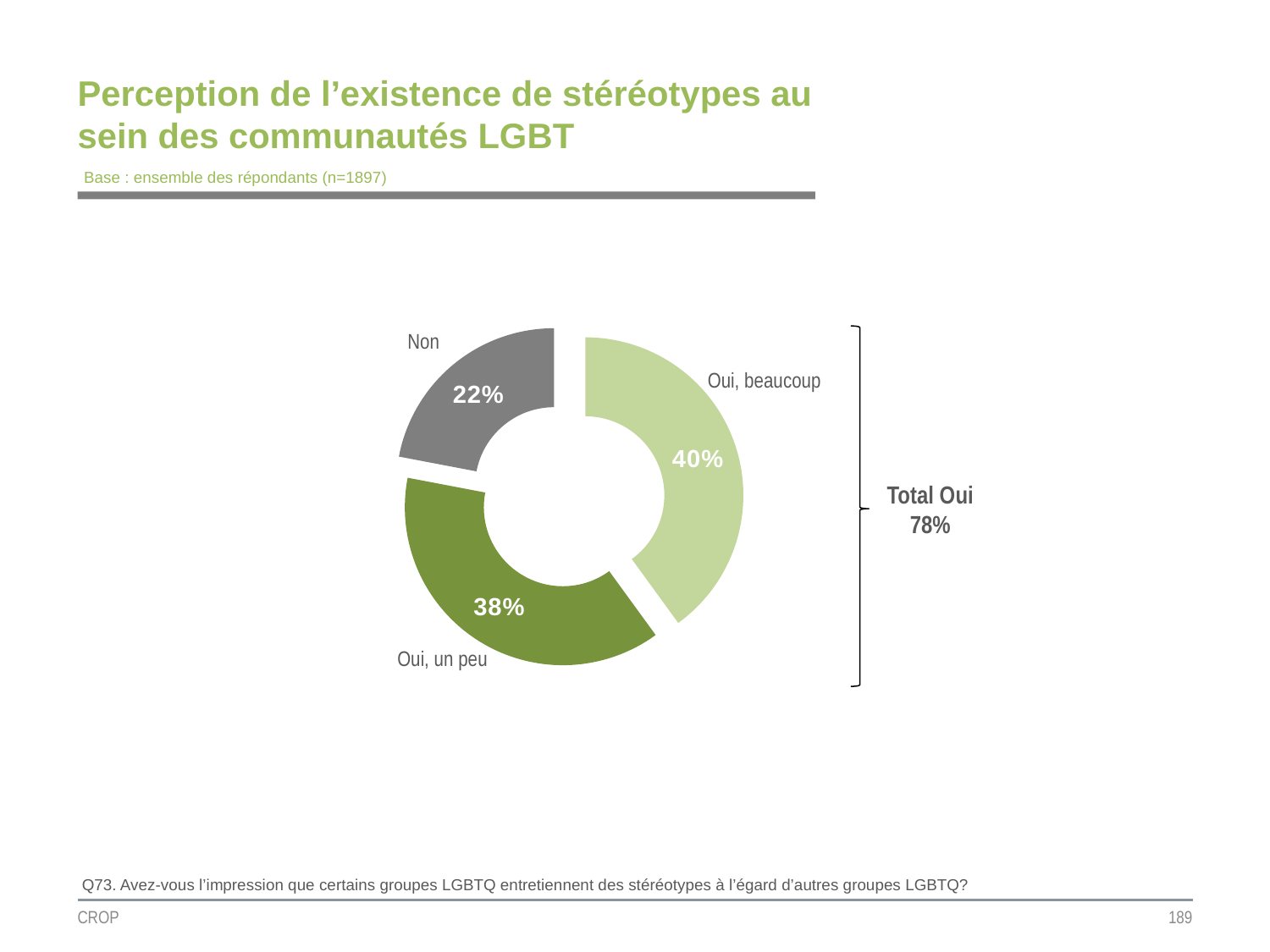
Which response category has the smallest share? Non What kind of chart is shown on the slide? Pie chart (doughnut) What is the difference in percentage points between "Oui, un peu" and "Non"? 16 What is the sample size (n) stated in the base line under the title? 1897 Which response category has the largest share? Oui, beaucoup What percentage of respondents answered "Oui, un peu"? 38% What percentage of respondents answered "Non"? 22% What is the combined share of the two "Oui" responses (Total Oui)? 78% What is the difference in percentage points between "Oui, beaucoup" and "Non"? 18 How many response categories are shown in the chart? 3 Which is larger, the share for "Oui, un peu" or the share for "Non"? Oui, un peu What percentage of respondents answered "Oui, beaucoup"? 40%